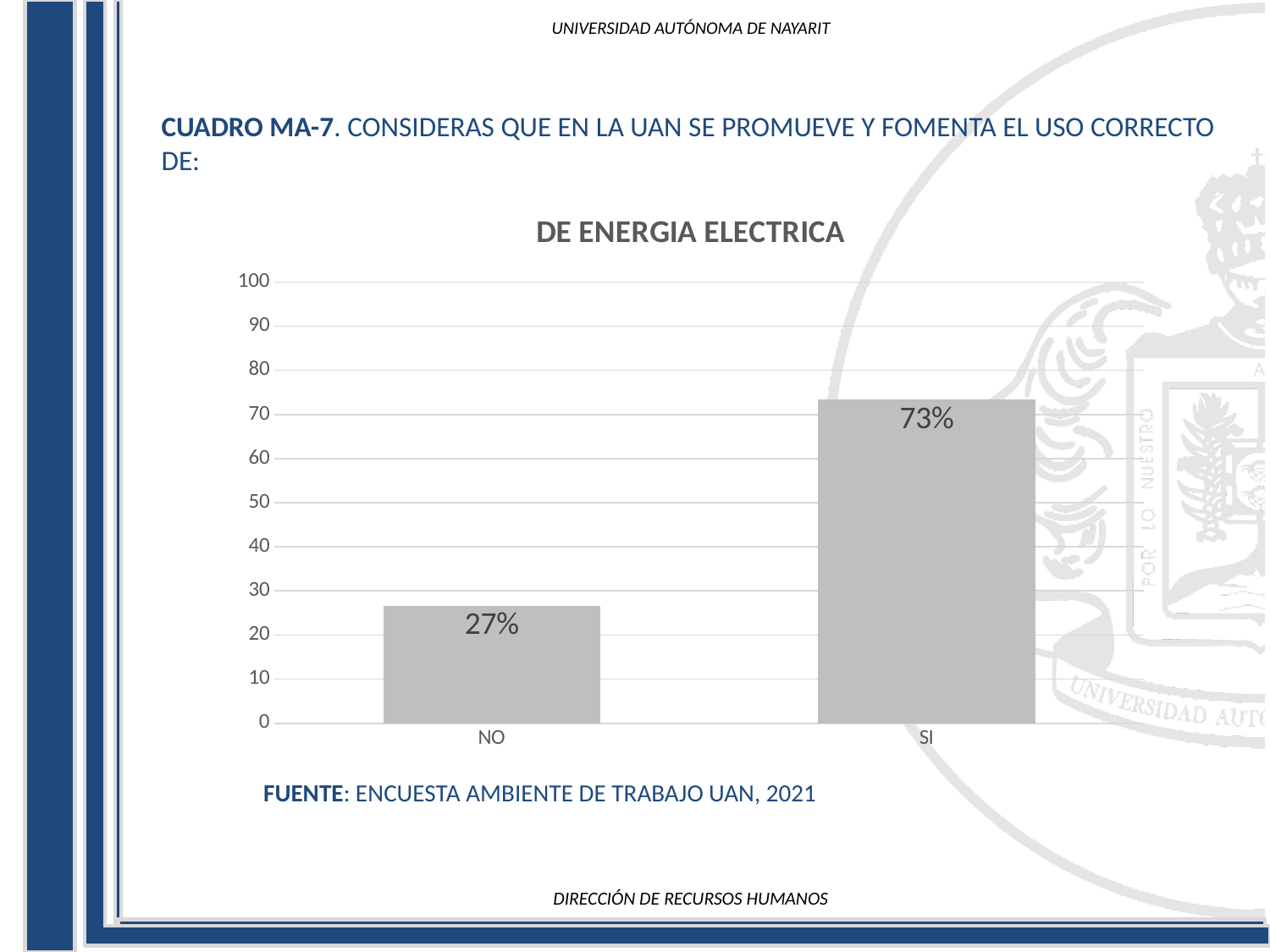
What is the value for SI? 73% What is the title of the chart? DE ENERGIA ELECTRICA Which is larger, the value for NO or the value for SI? SI What is the highest value shown on the y axis? 100 What is the difference between the values for SI and NO? 46% Is the value for SI greater or less than 60? greater How many categories are shown on the x axis? 2 Is the value for NO greater or less than 40? less Which category has the lowest value? NO Which category has the highest value? SI What is the value for NO? 27% What kind of chart is shown? bar chart